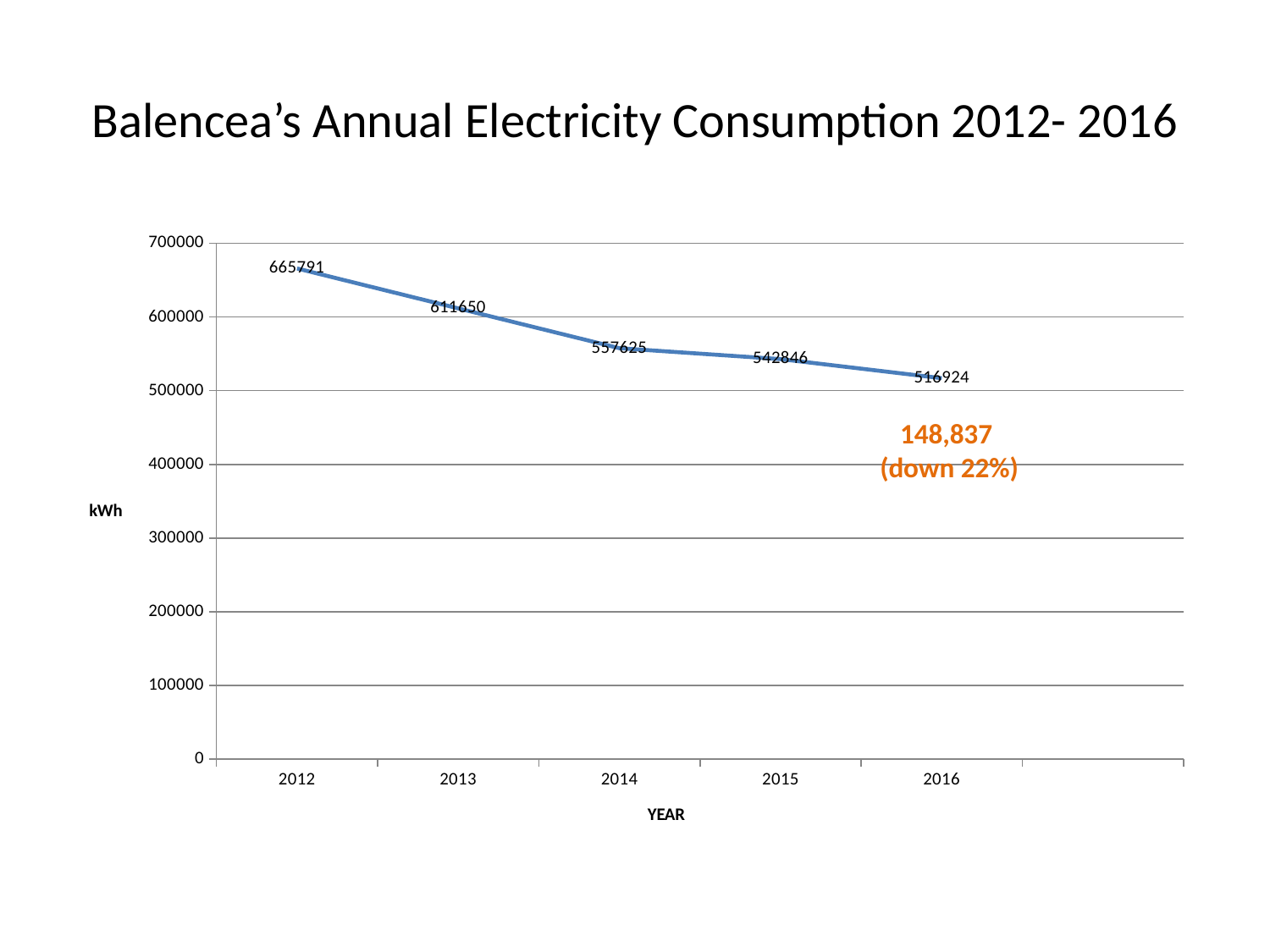
How many years are plotted on the chart? 5 Which year had higher consumption, 2013 or 2015? 2013 What was the electricity consumption in 2016? 516924 Does electricity consumption rise or fall from 2012 to 2016? fall What was Balencea's electricity consumption in 2012? 665791 What kind of chart is shown on the slide? line chart What is the difference in consumption between 2012 and 2016? 148867 What was the electricity consumption in 2014? 557625 Is the value for 2015 greater or less than 500000? greater Which year had the lowest electricity consumption? 2016 Which year had the highest electricity consumption? 2012 What is the difference in consumption between 2013 and 2014? 54025